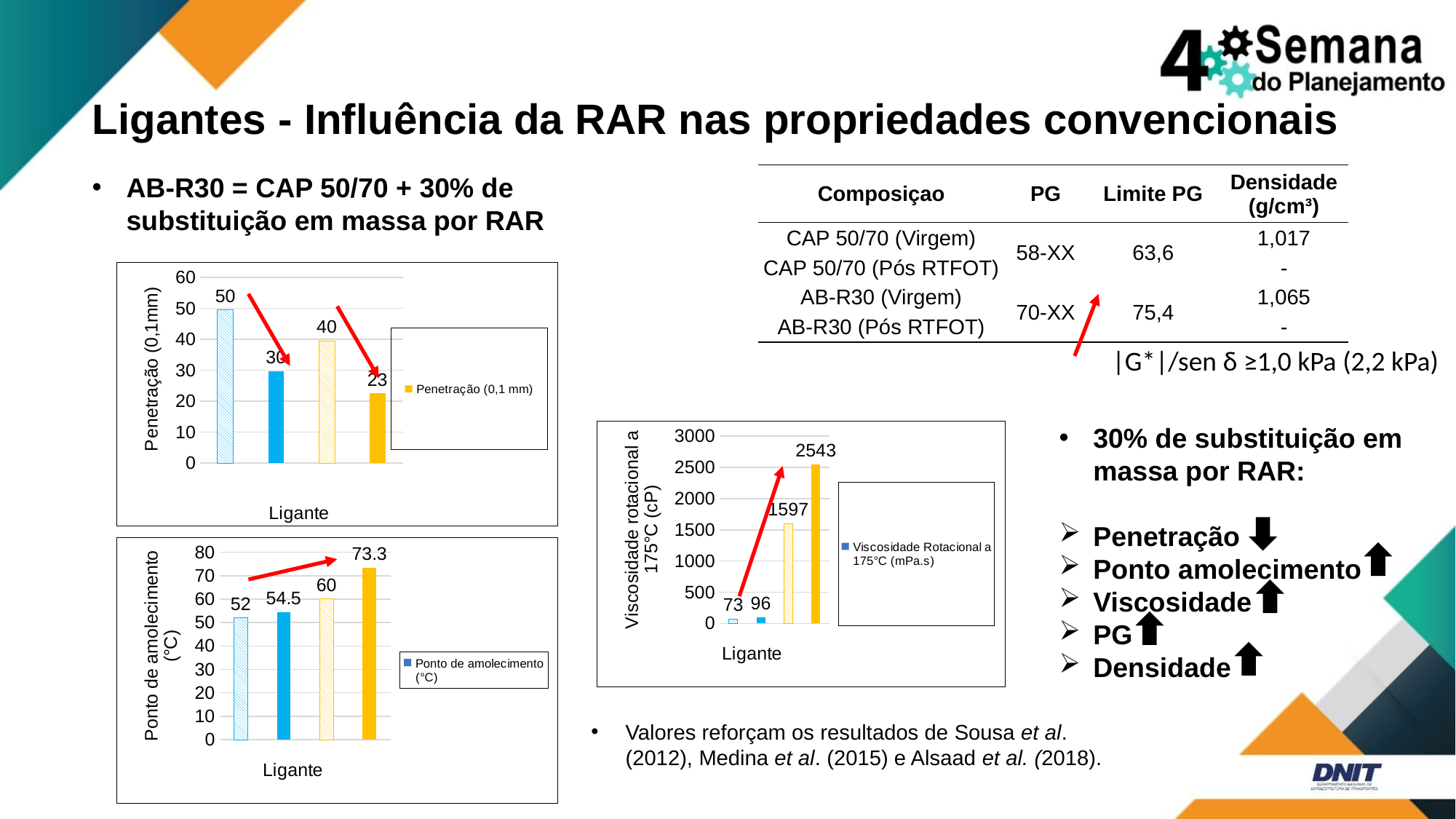
In the softening point chart (bottom-left), do the values rise or fall from left to right? rise In the penetration chart (top-left), what is the highest value shown? 50 In the penetration chart (top-left), what is the difference between the highest and lowest values? 27 In the softening point chart (bottom-left), what is the difference between the second bar (54.5) and the first bar (52)? 2.5 In the viscosity chart (middle, y-axis 'Viscosidade rotacional a 175°C (cP)'), what is the highest value shown? 2543 In the penetration chart (top-left), what is the lowest value shown? 23 In the viscosity chart (middle), what is the lowest value shown? 73 In the softening point chart (bottom-left, y-axis 'Ponto de amolecimento (°C)'), what is the value of the rightmost bar? 73.3 What type of chart is the penetration chart (top-left, y-axis 'Penetração (0,1mm)')? bar chart In the viscosity chart (middle), is the third bar (1597) greater or less than 1500? greater In the penetration chart (top-left), how many bars are plotted? 4 What legend entry is shown in the viscosity chart (middle)? Viscosidade Rotacional a 175°C (mPa.s)